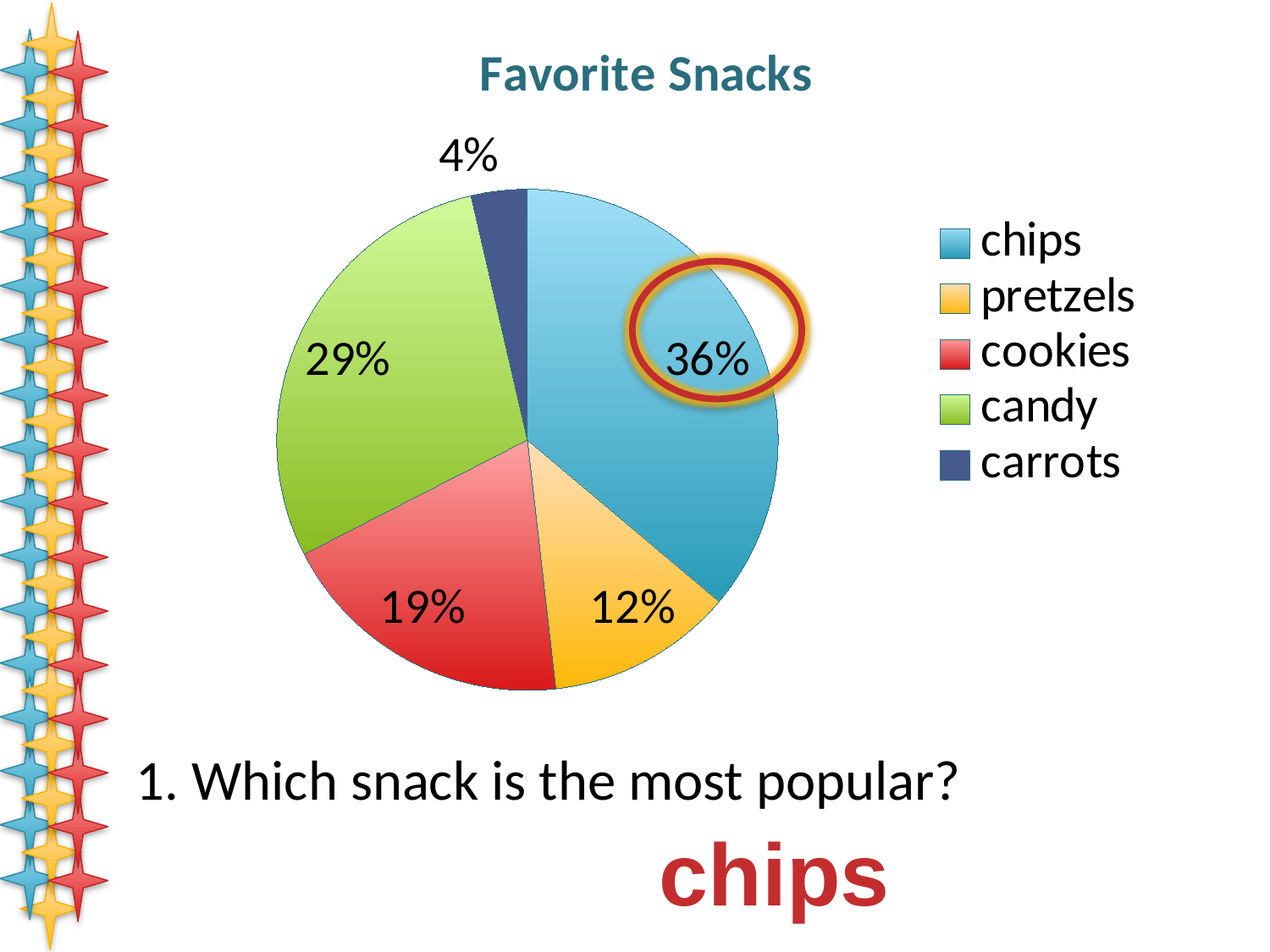
What is the title of the chart? Favorite Snacks What is the difference in percentage points between chips and candy? 7 Which snack has the smallest slice of the pie? carrots What share of the pie does pretzels have? 12% What share of the pie does chips have? 36% Which snack has the largest slice of the pie? chips What kind of chart is shown on the slide? pie chart How many snack categories are shown in the pie chart? 5 What share of the pie does carrots have? 4% Which has a larger share, cookies or pretzels? cookies